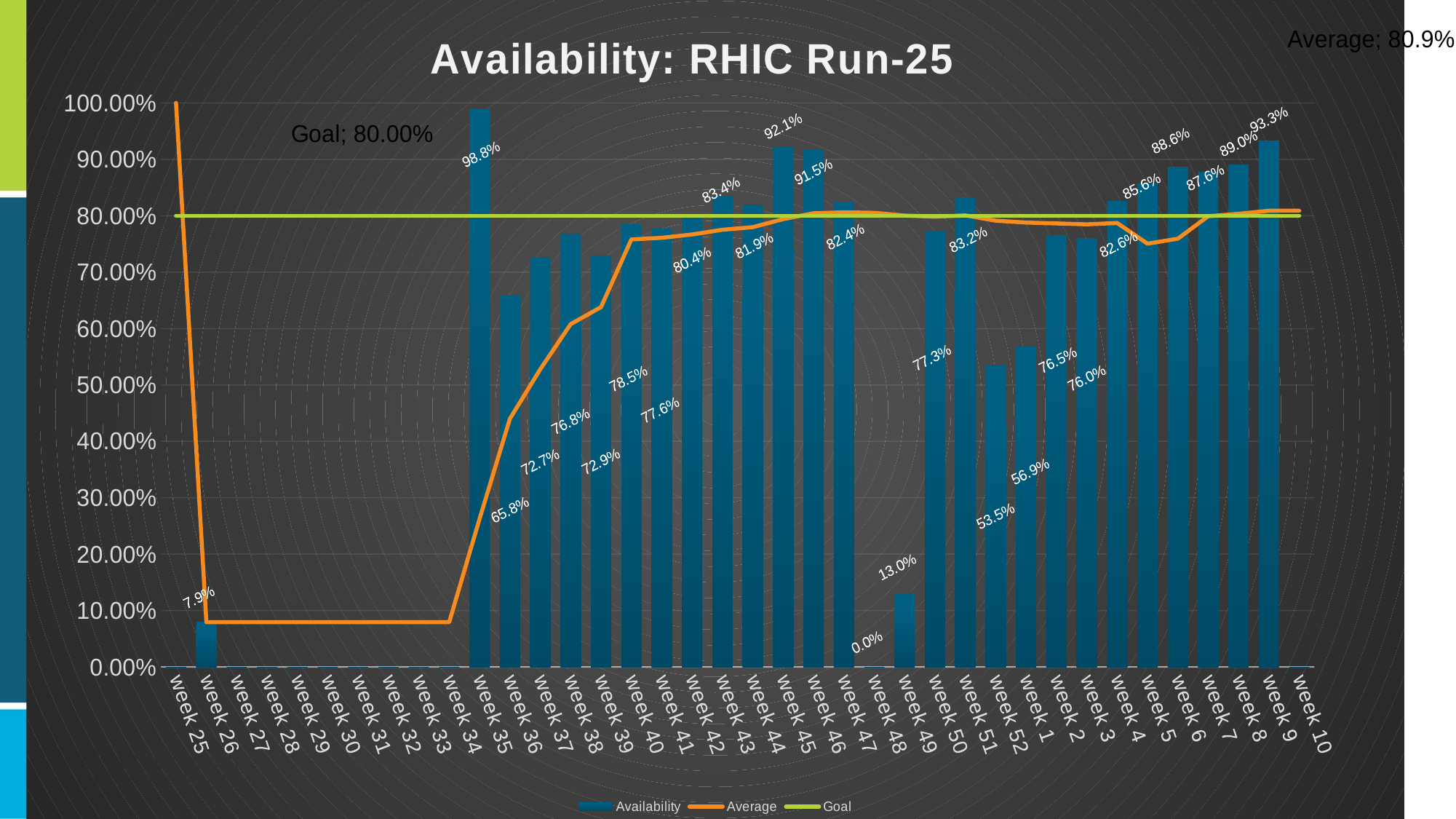
Which has the higher availability, week 52 or week 1? week 1 What is the availability value for week 35? 98.8% What kind of chart is shown on the slide? combination bar and line chart What is the availability value for week 26? 7.9% Which week has the highest availability? week 35 What is the availability value for week 49? 13.0% How many series does the legend list? 3 What is the availability value for week 9? 93.3% What goal value is shown on the chart? 80.00% What is the difference between the availability for week 9 and week 8? 4.3% What is the title of the chart? Availability: RHIC Run-25 Is the availability for week 36 greater or less than 70.00%? less